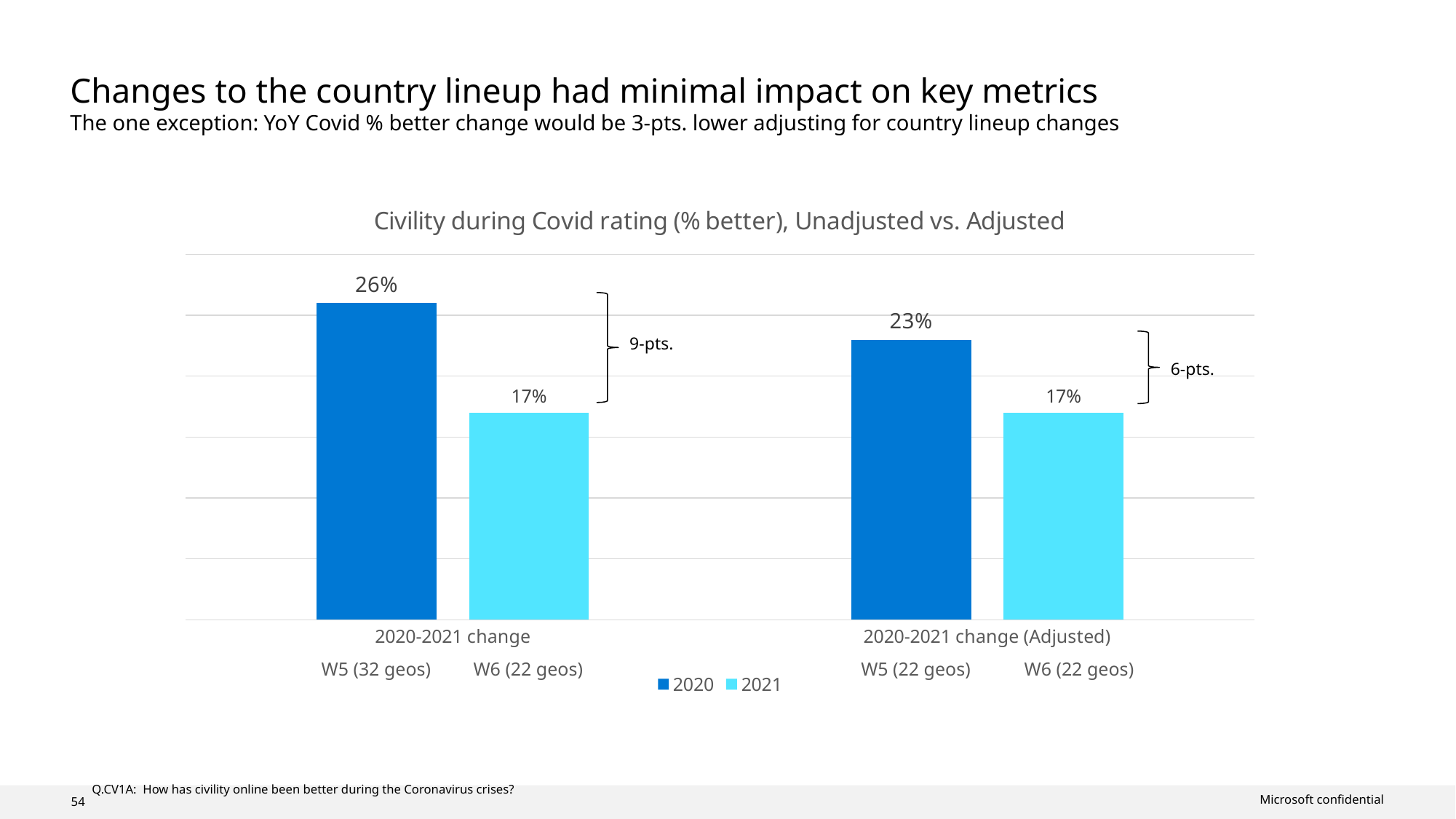
What is the difference between the 2020 and 2021 values in the 2020-2021 change (Adjusted) group? 6-pts. Which is larger: the 2020 value in the unadjusted group or the 2020 value in the adjusted group? The unadjusted group (26%) What is the 2021 value for the 2020-2021 change (Adjusted) group? 17% What kind of chart is shown on the slide? Bar chart What is the 2020 value for the 2020-2021 change (Adjusted) group? 23% What is the title of the chart? Civility during Covid rating (% better), Unadjusted vs. Adjusted How many series does the legend list? 2 What is the 2020 value for the 2020-2021 change (unadjusted) group? 26% What is the difference between the 2020 and 2021 values in the unadjusted 2020-2021 change group? 9-pts. How many geos are included in W5 for the unadjusted 2020-2021 change group? 32 geos Which bar has the highest value in the chart? 2020 in the 2020-2021 change (unadjusted) group, 26% How many bars are plotted in the chart? 4